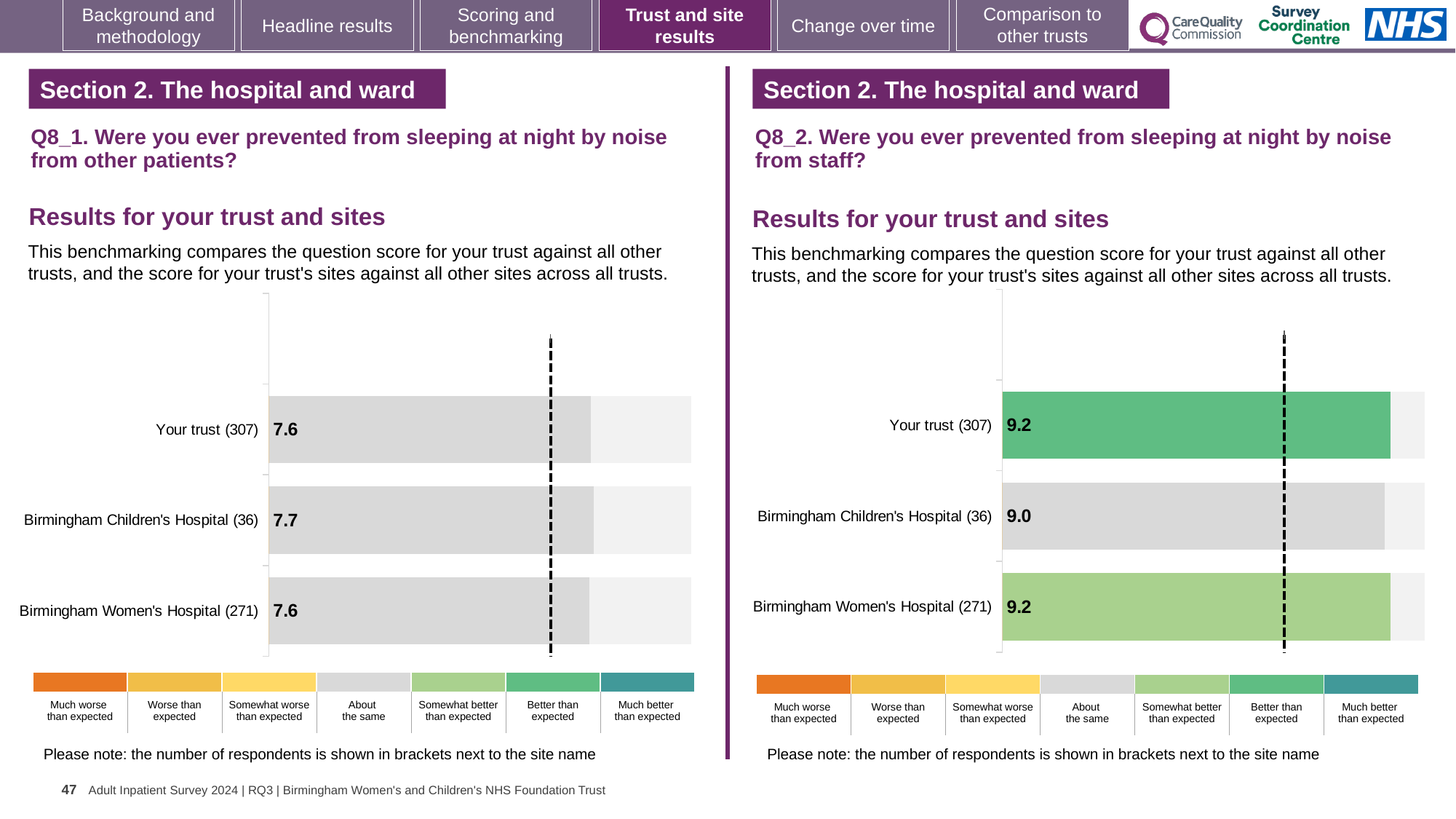
In the Q8_1 chart (left), what is the score for Your trust? 7.6 In the Q8_1 chart (left), which site or trust has the highest score? Birmingham Children's Hospital In the Q8_2 chart (right), how many respondents are shown in brackets for Birmingham Women's Hospital? 271 In the Q8_2 chart (right), what is the score for Birmingham Children's Hospital? 9.0 In the Q8_1 chart (left), what is the difference between the score for Birmingham Children's Hospital and the score for Birmingham Women's Hospital? 0.1 How many bars are plotted in the Q8_1 chart (left)? 3 In the Q8_2 chart (right), what is the difference between the score for Your trust and the score for Birmingham Children's Hospital? 0.2 In the Q8_2 chart (right), is the score for Your trust larger or smaller than the score for Birmingham Children's Hospital? larger What type of chart is used for the Q8_2 results (right)? bar chart In the Q8_1 chart (left), what is the score for Birmingham Children's Hospital? 7.7 In the Q8_2 chart (right), what is the score for Birmingham Women's Hospital? 9.2 In the Q8_2 chart (right), which site or trust has the lowest score? Birmingham Children's Hospital